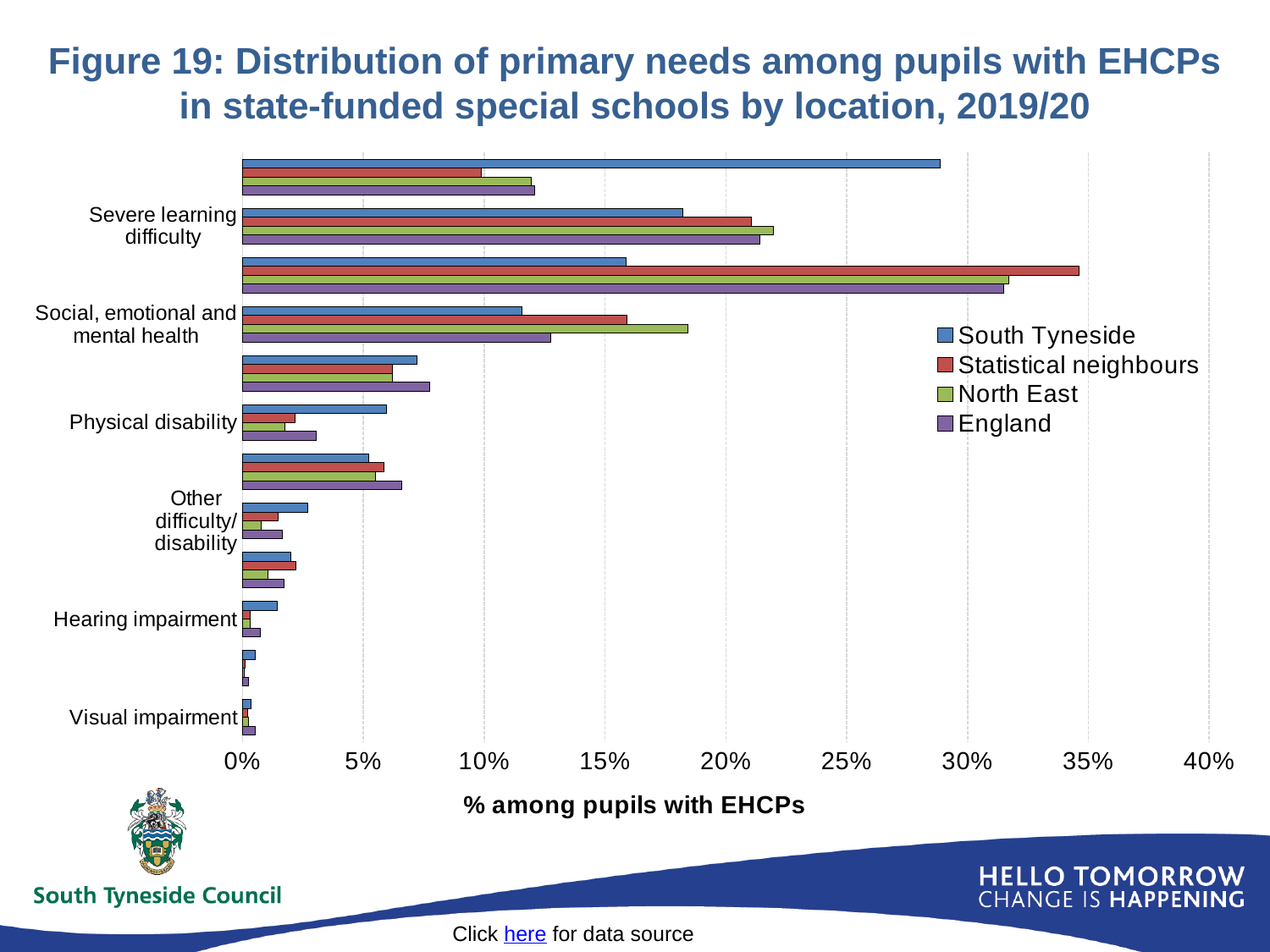
Which locations are listed in the legend? South Tyneside, Statistical neighbours, North East, England Is the South Tyneside value for Severe learning difficulty greater or less than 20%? less What kind of chart is shown on the slide? Bar chart For Physical disability, which is larger: the South Tyneside value or the England value? South Tyneside Is the North East value for Social, emotional and mental health greater or less than 15%? greater How many series does the legend list? 4 Is the South Tyneside value for Physical disability greater or less than 5%? greater For Social, emotional and mental health, which location has the highest value? North East For Severe learning difficulty, which location has the lowest value? South Tyneside What is the title of the x axis? % among pupils with EHCPs